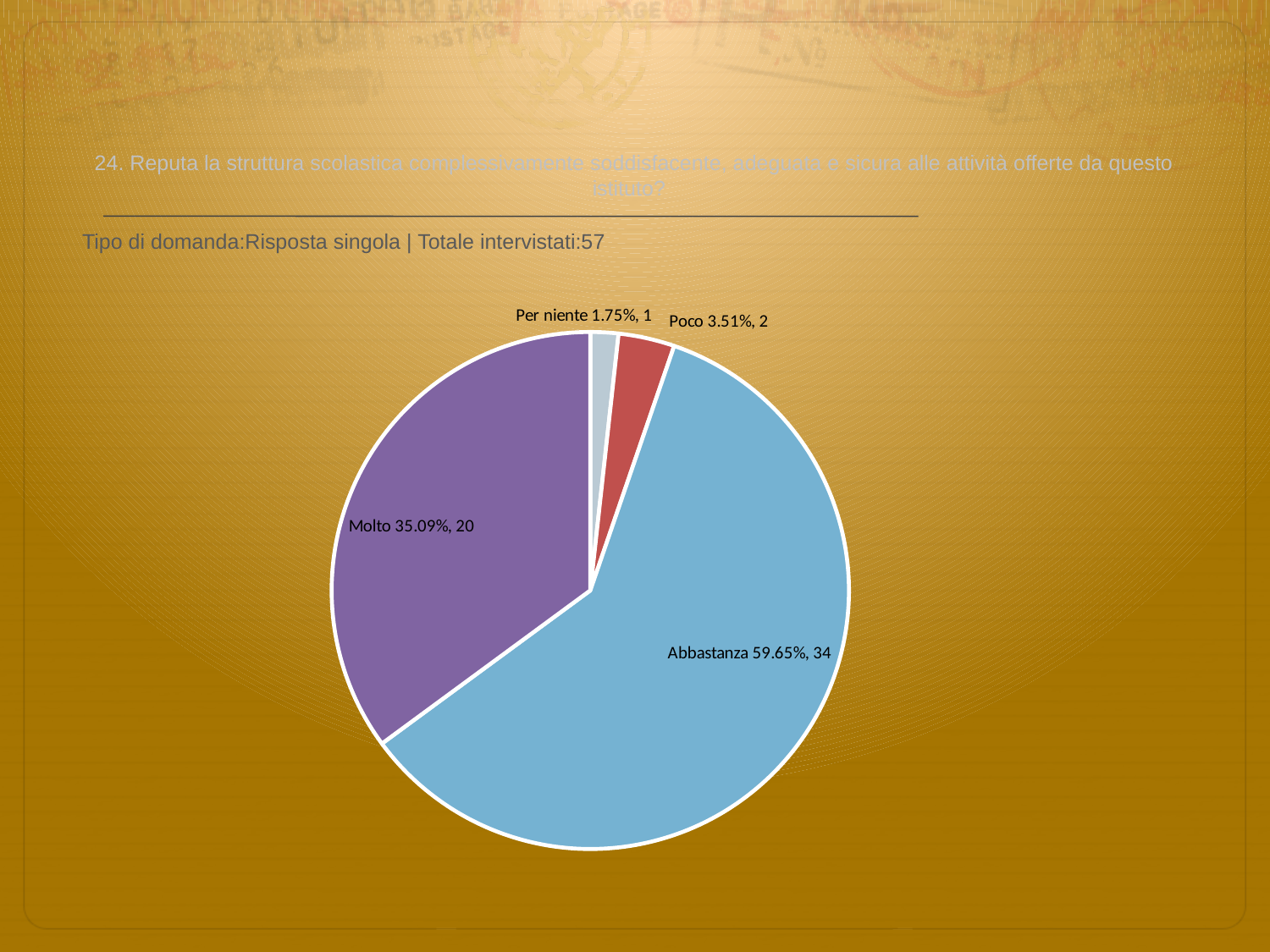
What kind of chart is shown on the slide? pie chart How many respondents answered Per niente? 1 What percentage share does the Abbastanza slice have? 59.65% What colour is the Molto slice? purple Which has more respondents, Poco or Per niente? Poco What percentage share does the Poco slice have? 3.51% Which category has the largest slice? Abbastanza Which category has the smallest slice? Per niente How many slices does the pie chart have? 4 How many respondents answered Molto? 20 What is the total number of respondents across all slices? 57 What is the difference in respondent count between Abbastanza and Molto? 14